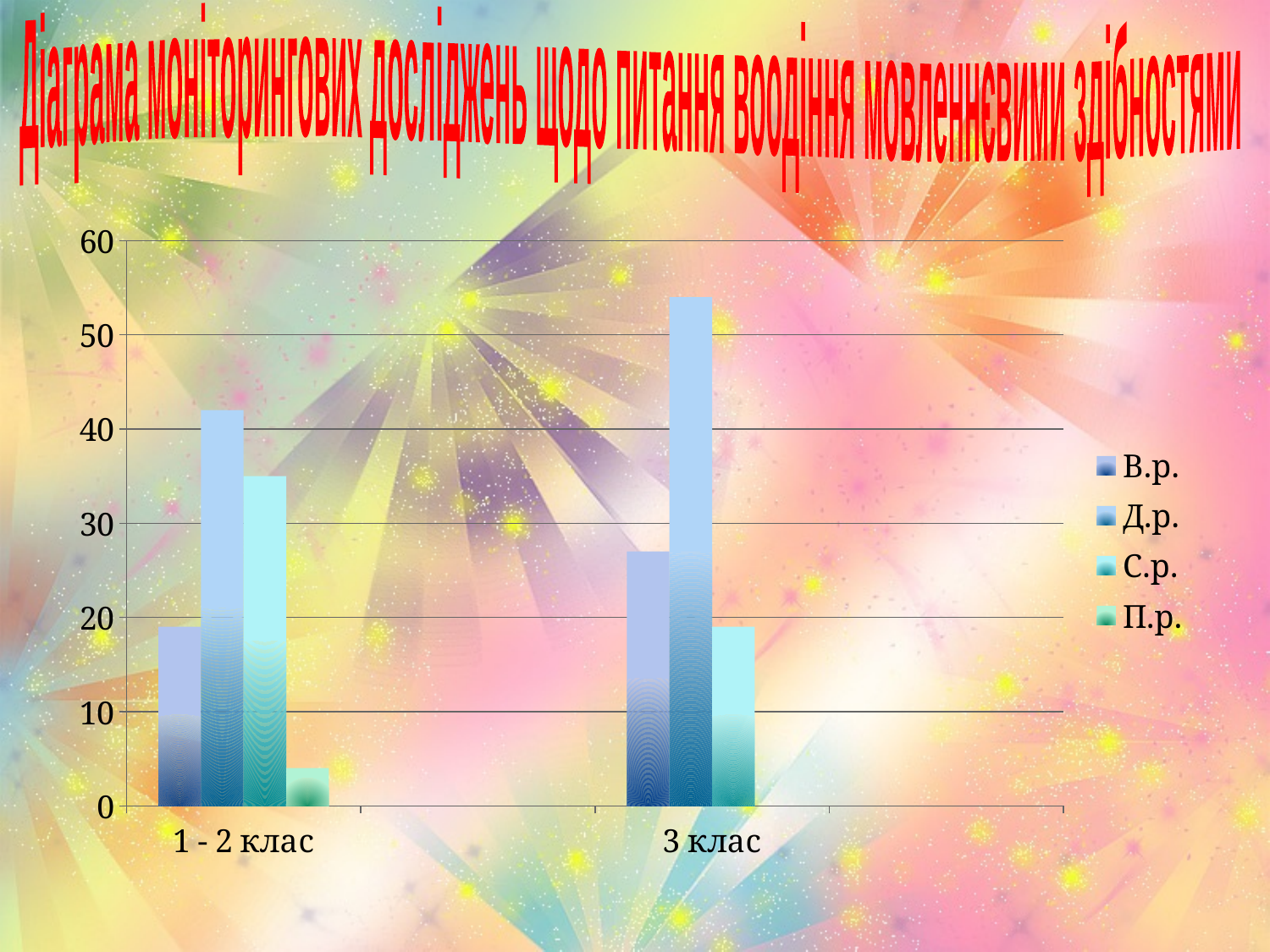
What is the last entry listed in the legend? П.р. Is the value for Д.р. in 3 клас greater or less than 50? greater How many series does the legend list? 4 Which series has the lowest value for 1 - 2 клас? П.р. Which is larger: the value for С.р. in 1 - 2 клас or the value for С.р. in 3 клас? 1 - 2 клас Which series has the highest value for 3 клас? Д.р. Which is larger: the value for В.р. in 1 - 2 клас or the value for В.р. in 3 клас? 3 клас Is the value for Д.р. in 1 - 2 клас greater or less than 40? greater How many categories are shown on the x axis? 2 What kind of chart is shown on the slide? bar chart